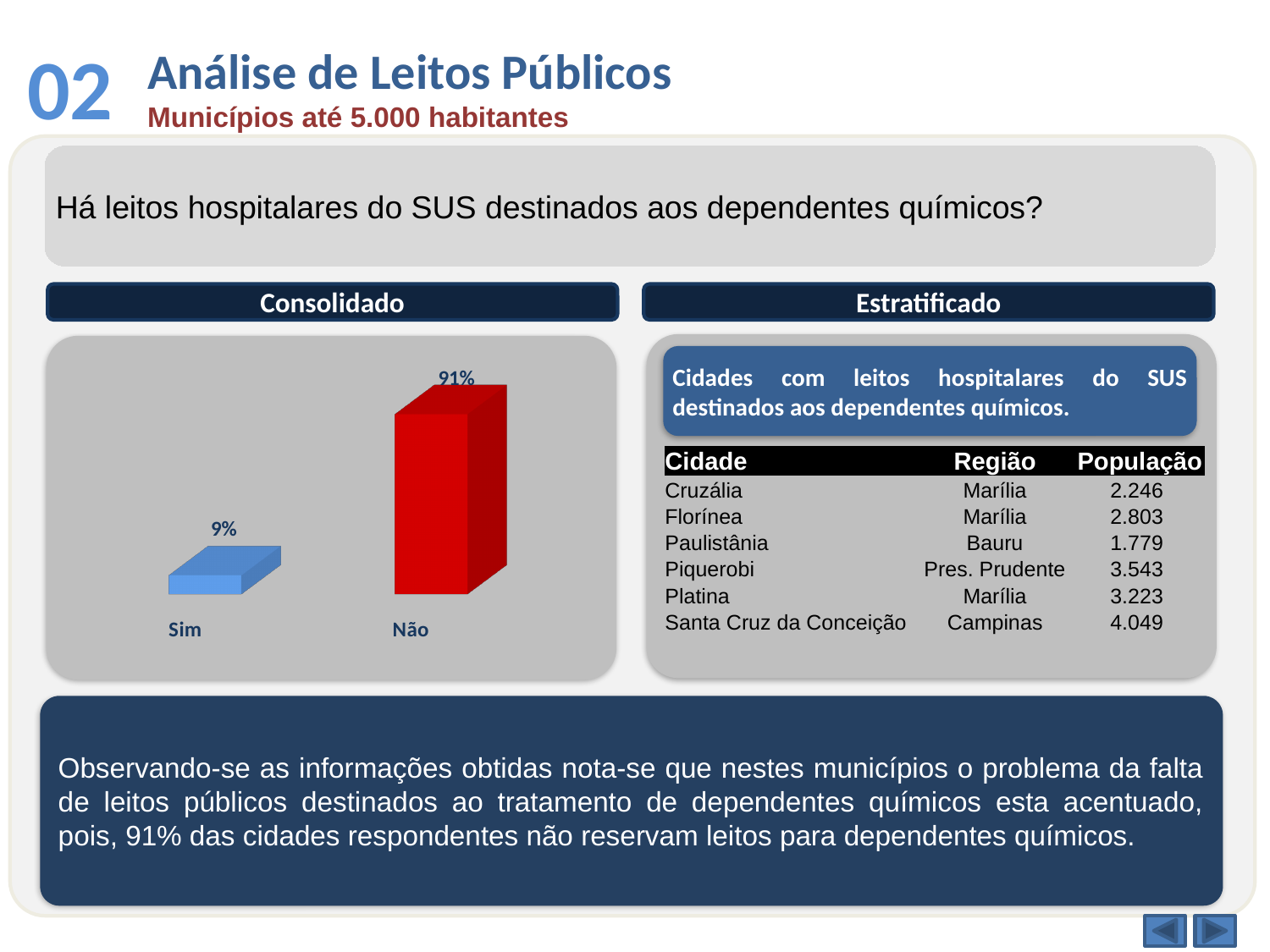
What is the difference between the 'Não' and 'Sim' values in the chart? 82% Which is larger in the chart, the value for 'Sim' or the value for 'Não'? Não What kind of chart is shown on the slide? Bar chart What colour is the 'Não' bar in the chart? Red How many categories are plotted in the chart? 2 What colour is the 'Sim' bar in the chart? Blue Which category has the lowest value in the chart? Sim What is the total of the 'Sim' and 'Não' values in the chart? 100% What value is shown for the 'Sim' bar in the chart? 9% What value is shown for the 'Não' bar in the chart? 91% Which category has the highest value in the chart? Não